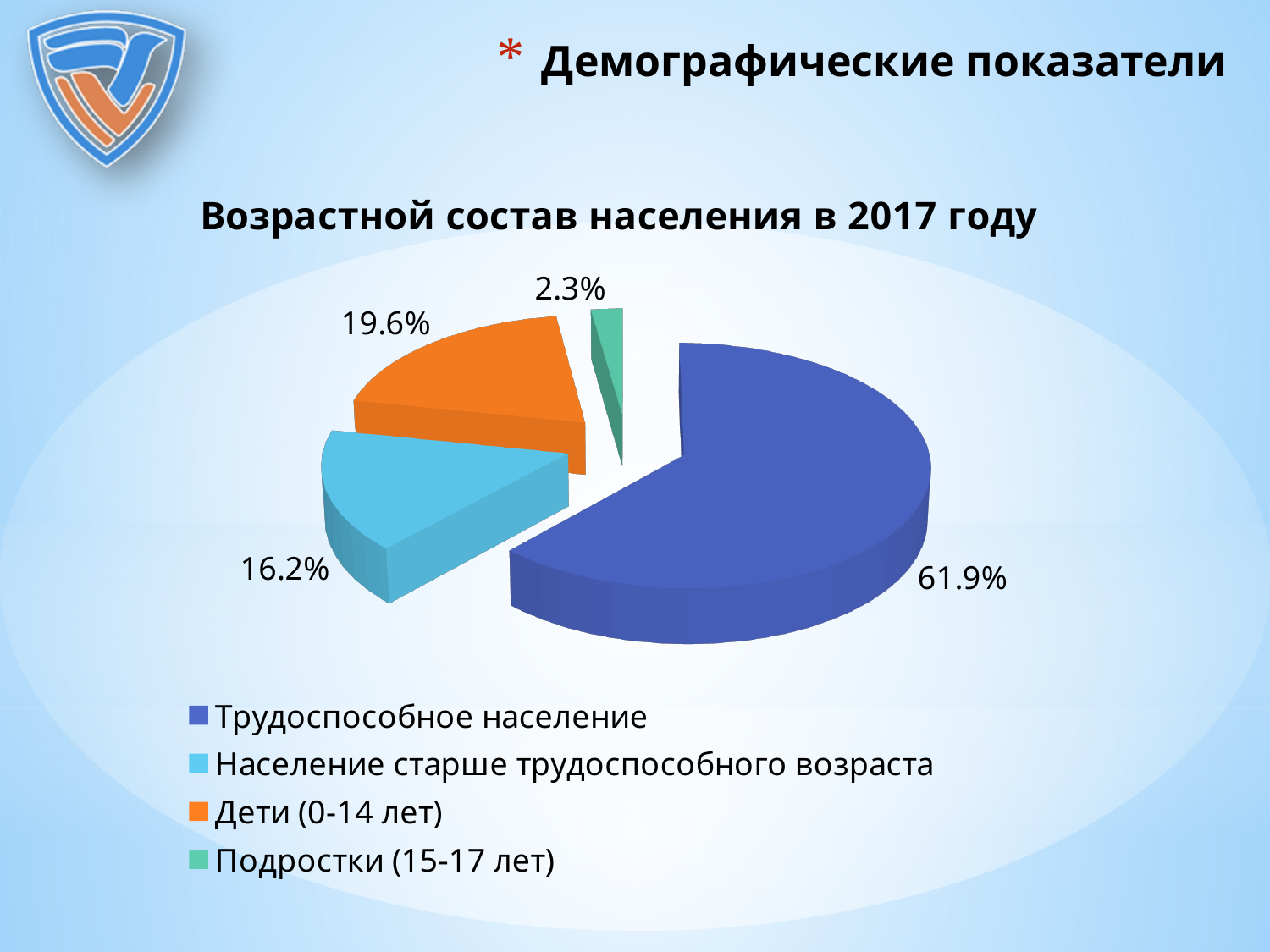
What type of chart is shown on the slide? Pie chart What share of the population is Население старше трудоспособного возраста? 16.2% Which category has the smallest share of the pie? Подростки (15-17 лет) What share of the population is Дети (0-14 лет)? 19.6% What share of the population is Трудоспособное население? 61.9% What is the difference in percentage points between Трудоспособное население and Дети (0-14 лет)? 42.3 What colour is the slice for Дети (0-14 лет)? Orange Which category has the largest share of the pie? Трудоспособное население Which is larger: the share for Дети (0-14 лет) or the share for Население старше трудоспособного возраста? Дети (0-14 лет) What share of the population is Подростки (15-17 лет)? 2.3% What is the title of the chart? Возрастной состав населения в 2017 году How many categories does the pie chart have? 4